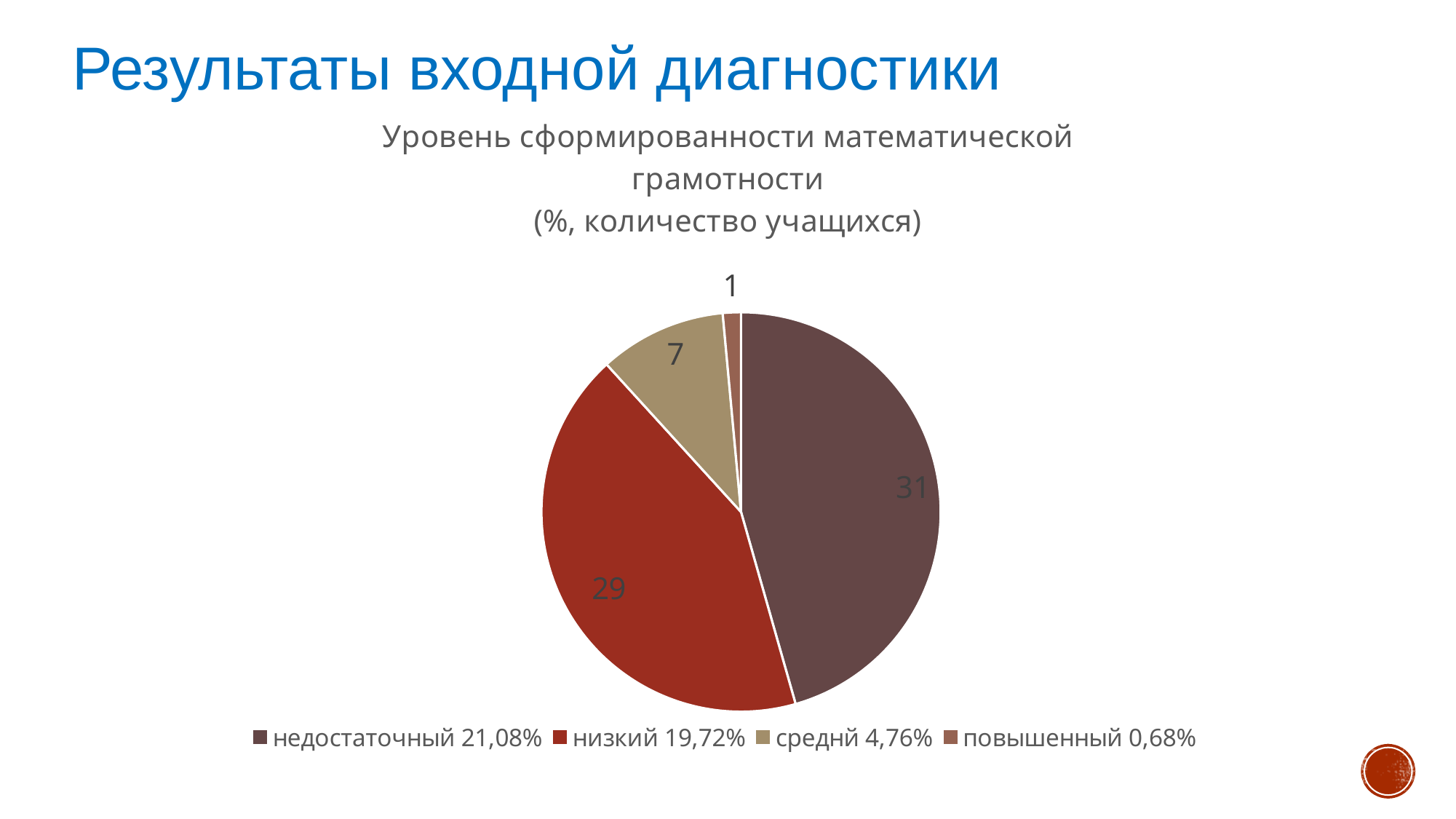
Which category has the smallest slice of the pie? повышенный What is the value shown for the недостаточный slice? 31 What is the total of all the slice values in the pie chart? 68 What is the value shown for the низкий slice? 29 How many slices does the pie chart have? 4 What kind of chart is shown on the slide? pie chart What is the difference between the values for недостаточный and низкий? 2 What is the value shown for the средний slice? 7 What percentage is shown in the legend next to низкий? 19,72% Which is larger, the value for средний or the value for повышенный? средний What is the value shown for the повышенный slice? 1 Which category has the largest slice of the pie? недостаточный